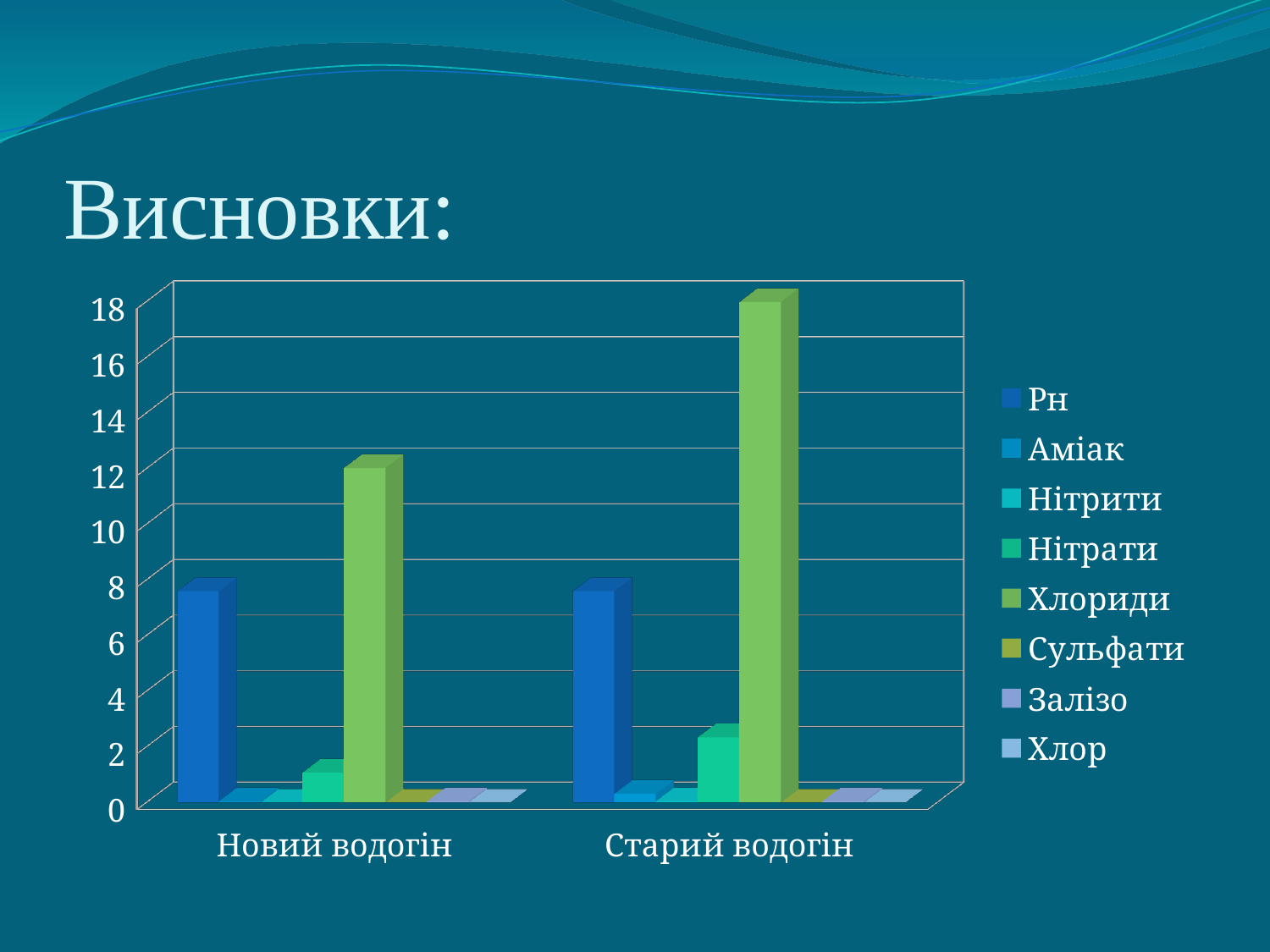
What is the first entry listed in the chart legend? Рн Which series has the highest bar for Старий водогін? Хлориди Is the value for Хлориди in Новий водогін greater or less than 14? less What kind of chart is shown on the slide? bar chart Is the value for Рн in Новий водогін greater or less than 6? greater Is the value for Хлориди in Старий водогін greater or less than 16? greater Which series has the highest bar for Новий водогін? Хлориди Which category has the larger value for Хлориди, Новий водогін or Старий водогін? Старий водогін Which category has the larger value for Нітрати, Новий водогін or Старий водогін? Старий водогін How many series does the chart legend list? 8 How many categories are shown on the x axis of the chart? 2